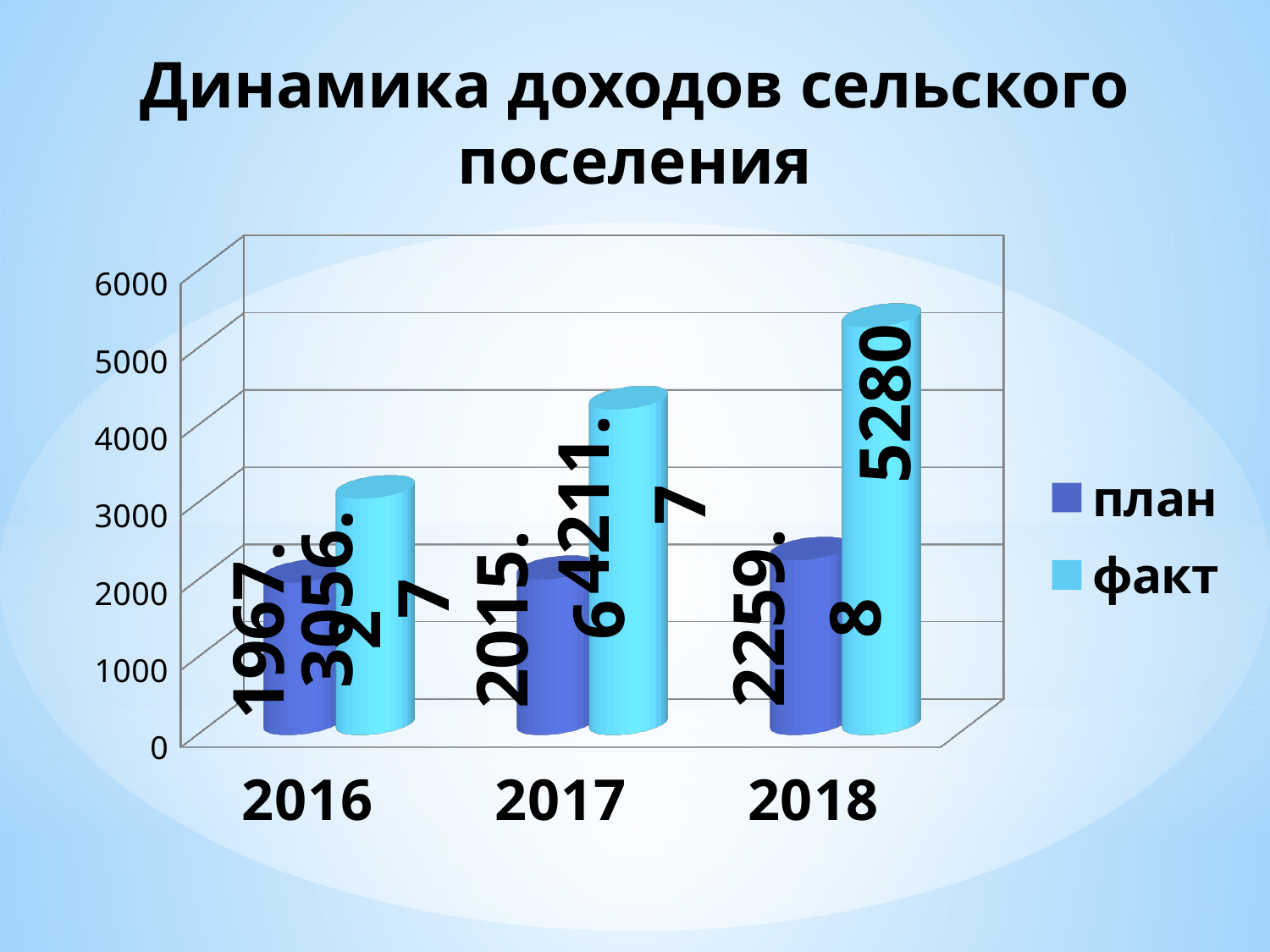
Which year has the highest факт value? 2018 What kind of chart is shown on the slide? bar chart How many series does the legend list? 2 In 2018, which is larger, план or факт? факт Which year has the lowest факт value? 2016 Is the план value for 2016 greater or less than 3000? less Is the факт value for 2017 greater or less than 4000? greater What is the факт value for 2018? 5280 How many years are shown on the x axis? 3 Which year has the highest план value? 2018 Do the факт values rise or fall from 2016 to 2018? rise What are the two entries in the legend? план, факт